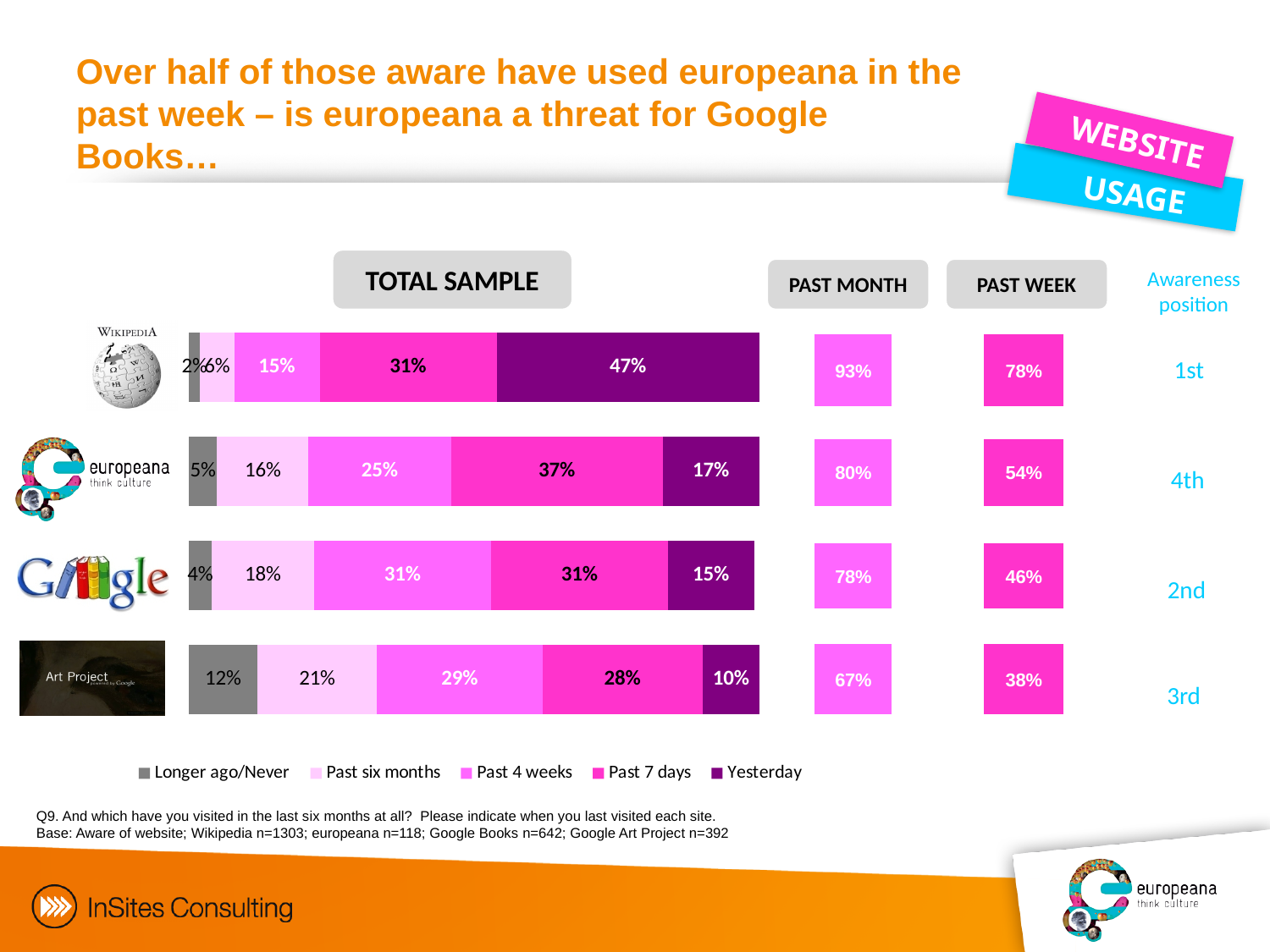
What is the 'Past 4 weeks' value for Google Books? 31% What kind of chart is used to show the total sample visit recency? Stacked bar chart Which website has the highest 'Yesterday' share? Wikipedia What is the 'Past 7 days' value for europeana in the stacked bar chart? 37% How many series does the legend of the stacked bar chart list? 5 What is the 'Longer ago/Never' value for Google Art Project? 12% Which website has the lowest 'Yesterday' share? Google Art Project What is the 'Past week' figure shown for europeana? 54% Which is larger: the 'Past six months' value for Google Art Project or for europeana? Google Art Project What is the difference between the 'Yesterday' values for europeana and Google Books? 2% How many websites are shown in the stacked bar chart? 4 What percentage of those aware of Wikipedia visited it yesterday? 47%